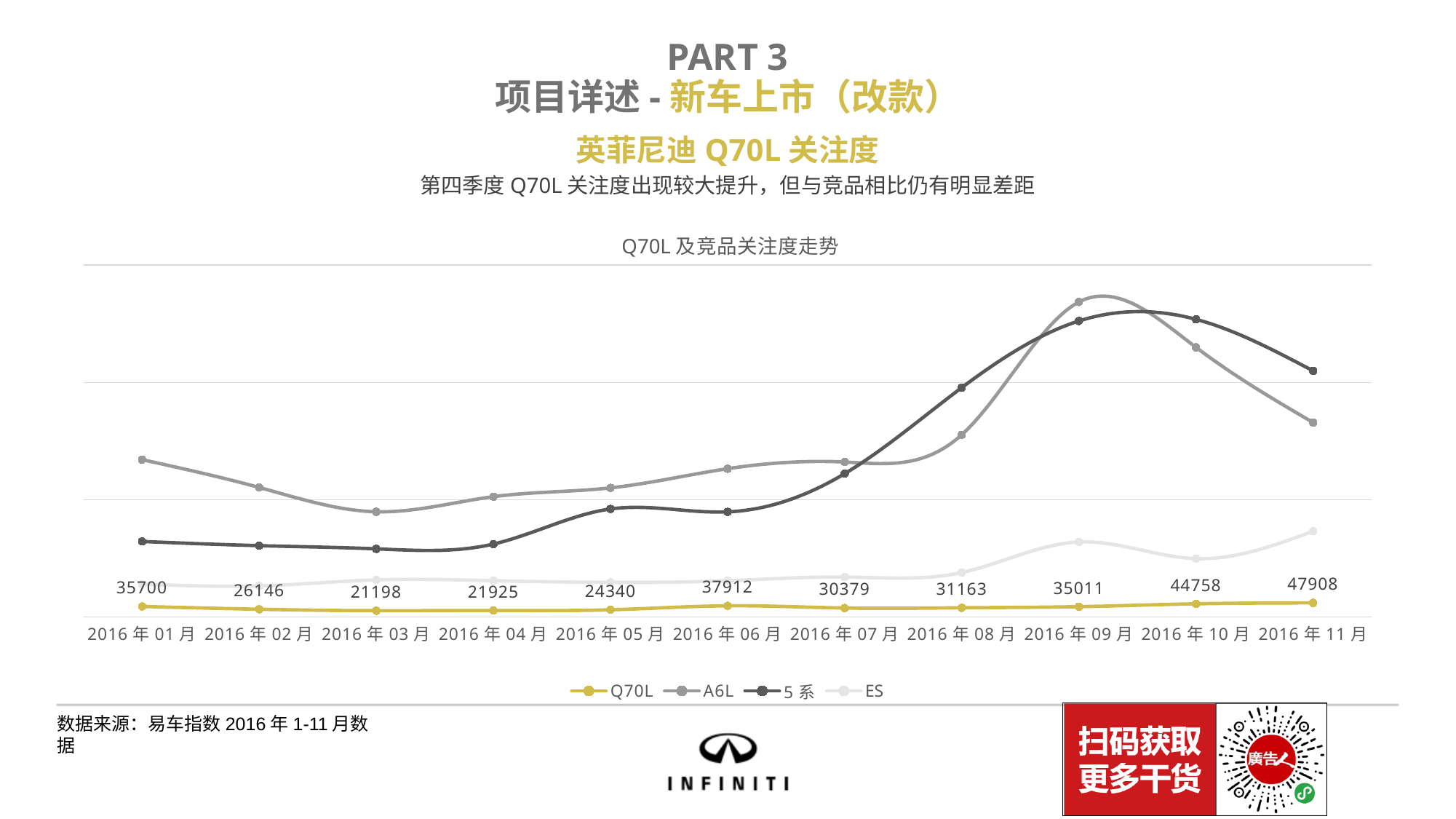
What is the Q70L value for 2016年01月? 35700 How many months are shown on the x axis? 11 What is the difference between the Q70L values for 2016年11月 and 2016年10月? 3150 What is the Q70L value for 2016年06月? 37912 In which month does the Q70L series reach its highest value? 2016年11月 Does the Q70L series rise or fall from 2016年08月 to 2016年11月? Rise Which is larger, the Q70L value for 2016年06月 or for 2016年07月? 2016年06月 What is the title of the chart? Q70L 及竞品关注度走势 What is the Q70L value for 2016年11月? 47908 In which month does the Q70L series have its lowest value? 2016年03月 How many series does the legend list? 4 What kind of chart is shown on the slide? Line chart